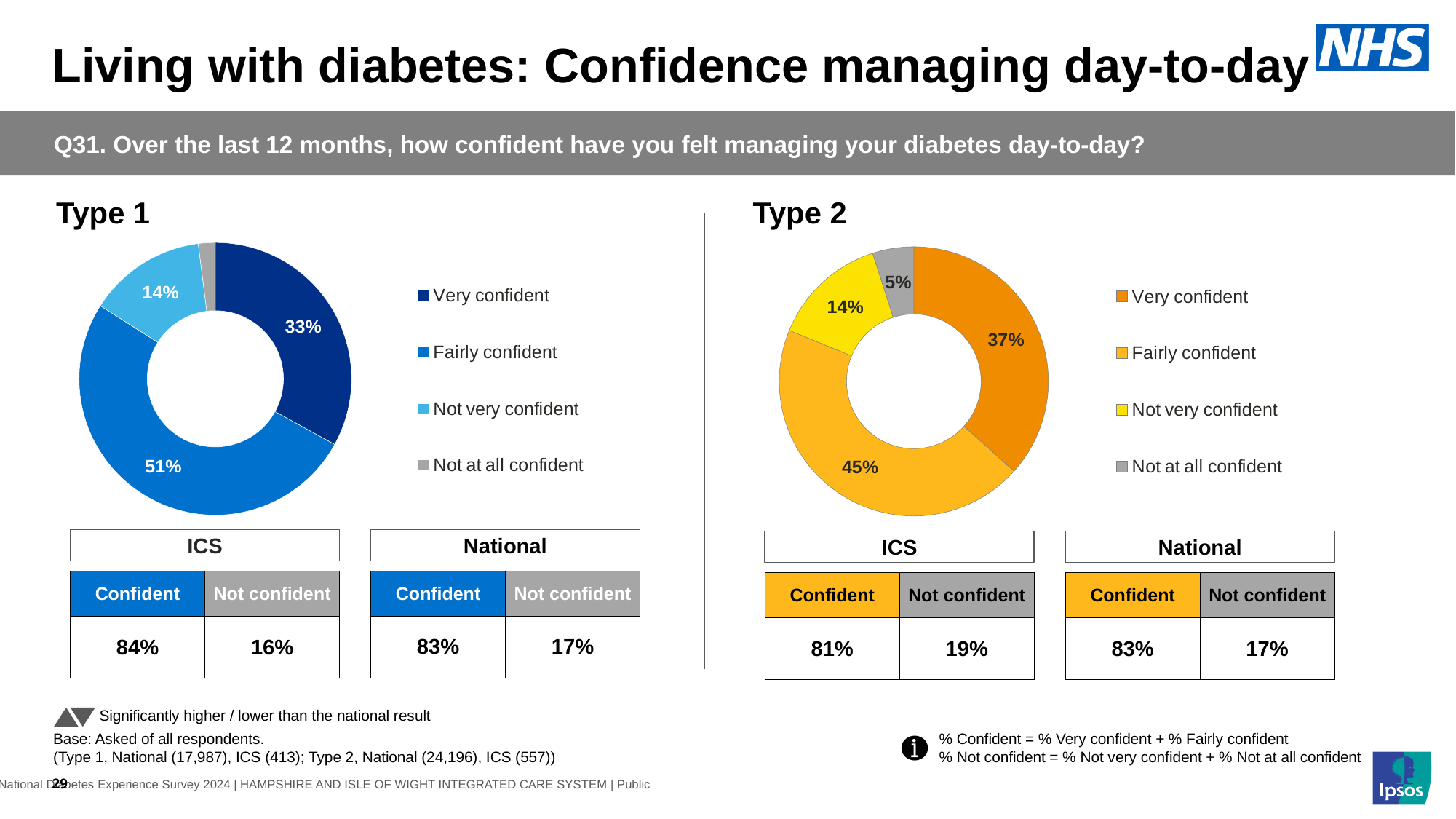
In the Type 1 chart, which category has the smallest share? Not at all confident In the Type 1 chart, what percentage of respondents were Fairly confident? 51% Which is larger in the Type 1 chart: the Very confident share or the Not very confident share? Very confident In the Type 2 chart, which category has the largest share? Fairly confident In the Type 1 chart, what percentage of respondents were Very confident? 33% In the Type 2 chart, what is the difference between the Fairly confident and Very confident shares? 8% In the Type 2 chart, what percentage of respondents were Not at all confident? 5% What colour represents Not very confident in the Type 2 chart? Yellow In the Type 1 chart, what is the combined share of Very confident and Fairly confident? 84% What kind of chart is used for Type 1? Donut (pie) chart How many categories does the legend of the Type 2 chart list? 4 In the Type 2 chart, what percentage of respondents were Fairly confident? 45%